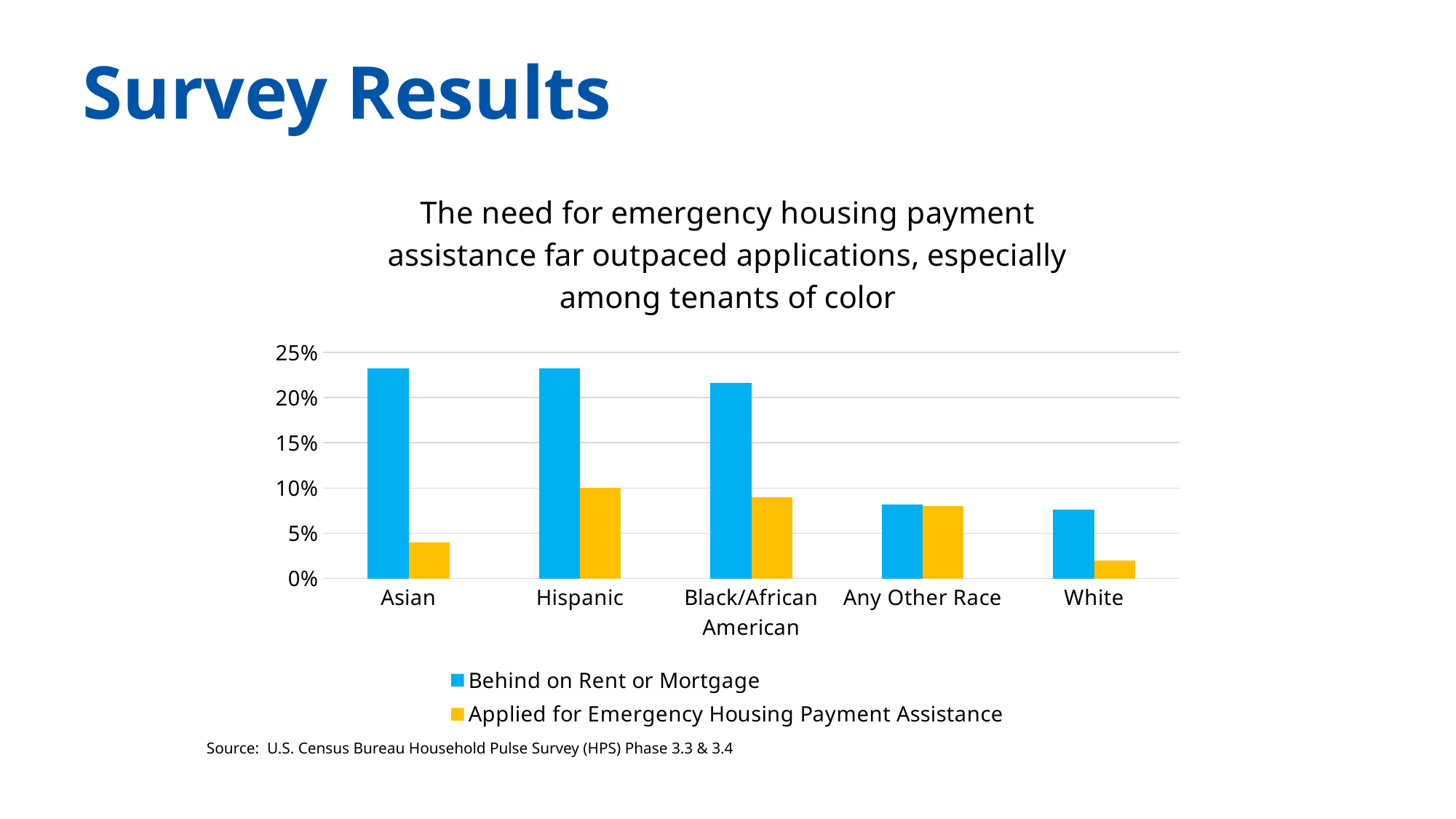
What kind of chart is shown on the slide? Bar chart In the Behind on Rent or Mortgage series, which is larger: Hispanic or Black/African American? Hispanic Is the value for Asian in the Behind on Rent or Mortgage series greater or less than 20%? greater How many series does the legend list? 2 Which category has the lowest value in the Applied for Emergency Housing Payment Assistance series? White Which category has the highest value in the Applied for Emergency Housing Payment Assistance series? Hispanic Which colour represents the Applied for Emergency Housing Payment Assistance series? Yellow Is the value for Any Other Race in the Behind on Rent or Mortgage series greater or less than 10%? less For Asian, which series has the larger value: Behind on Rent or Mortgage or Applied for Emergency Housing Payment Assistance? Behind on Rent or Mortgage Is the value for White in the Applied for Emergency Housing Payment Assistance series greater or less than 5%? less How many race categories are shown on the x axis? 5